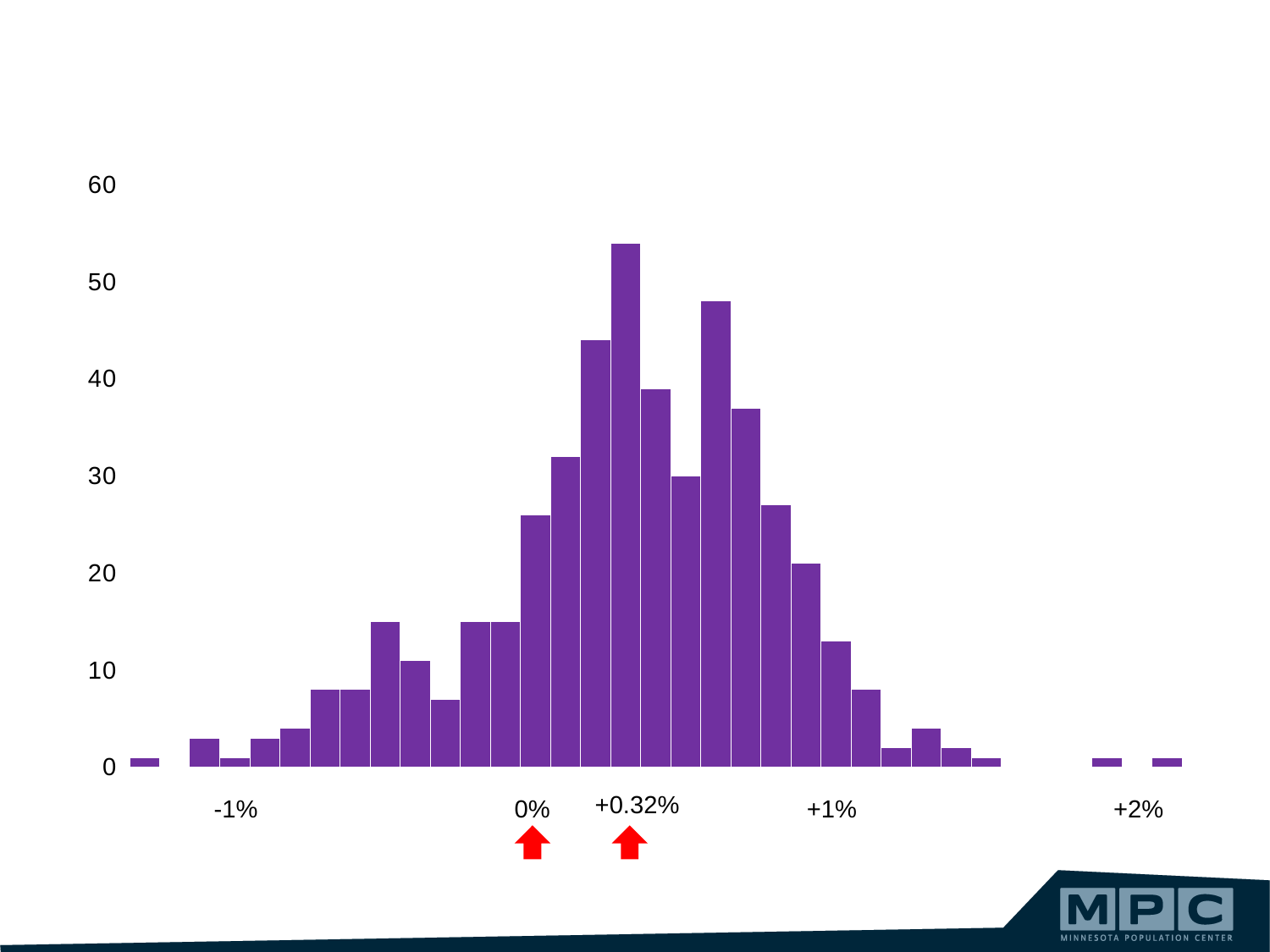
Is the value of the bar at the -1% mark on the x axis greater or less than 10? less Is the value of the bar at the +1% mark on the x axis greater or less than 10? greater What kind of chart is shown on the slide? bar chart What is the highest value shown on the y axis? 60 Do the bar heights generally rise or fall moving along the x axis from -1% to +0.32%? rise Which two x-axis labels are marked with red arrows? 0% and +0.32% Is the tallest bar on the chart greater or less than 60? less Near which labelled x-axis value is the tallest bar located? +0.32% Do the bar heights generally rise or fall moving along the x axis from +1% to +2%? fall